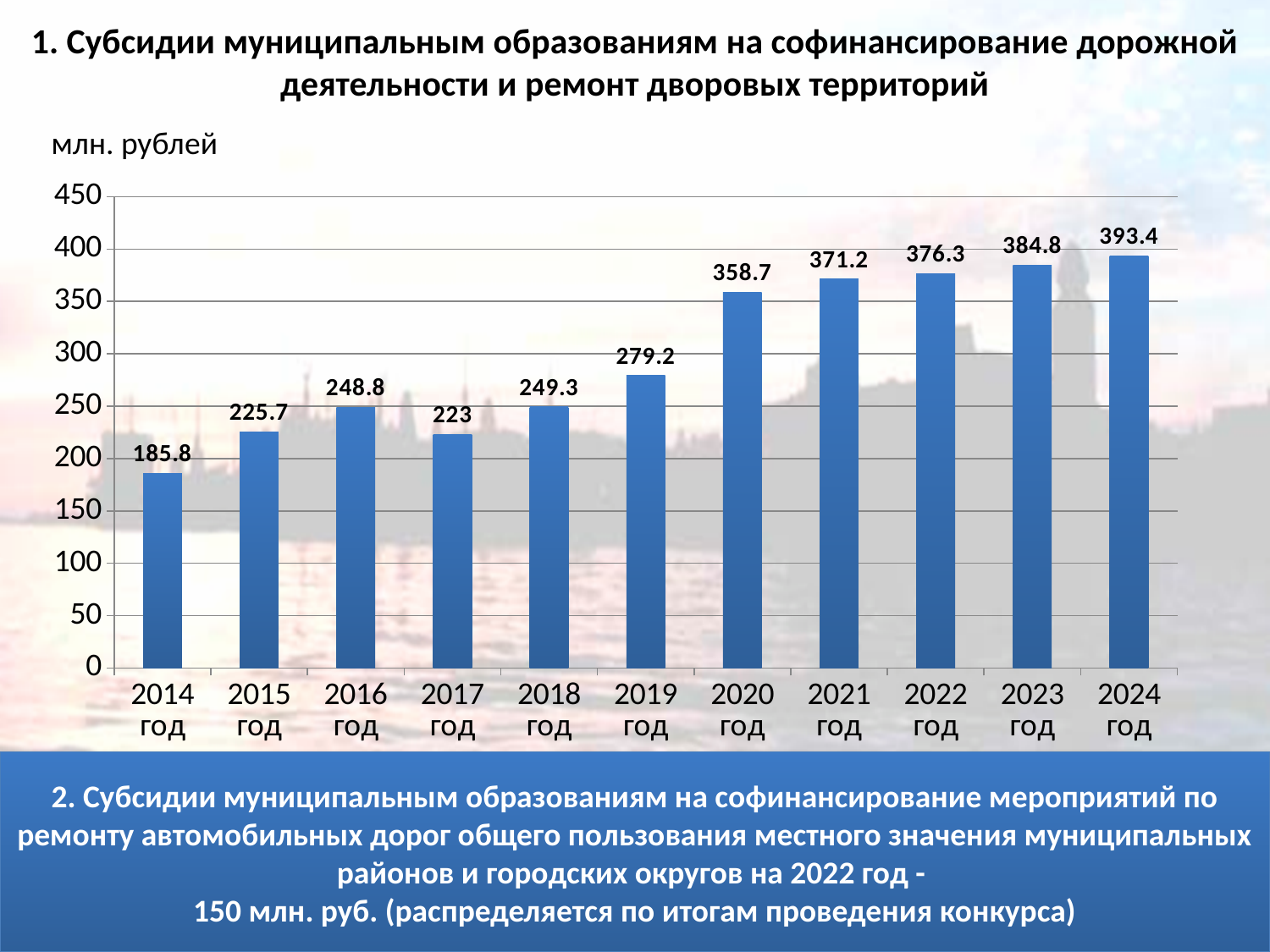
What unit is indicated above the chart's vertical axis? млн. рублей What is the value for 2017 год? 223 What is the value for 2020 год? 358.7 What is the difference between the values for 2024 год and 2014 год? 207.6 What is the difference between the values for 2020 год and 2019 год? 79.5 What is the value for 2014 год? 185.8 How many years are shown on the x axis? 11 What kind of chart is shown on the slide? bar chart Which is larger, the value for 2016 год or the value for 2017 год? 2016 год Is the value for 2019 год greater or less than 250? greater Which year has the highest value? 2024 год Which year has the lowest value? 2014 год